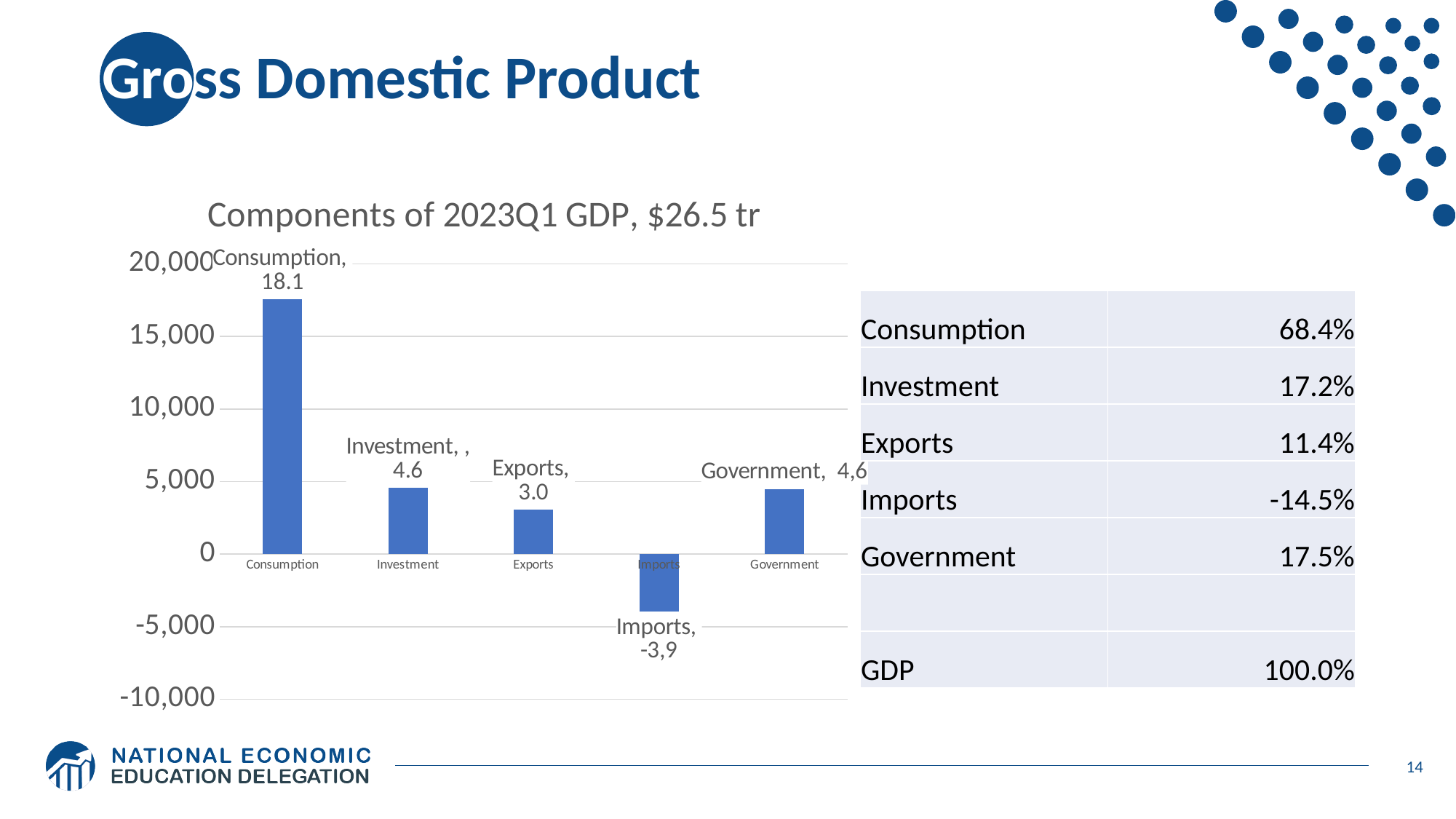
What is the difference between the labelled values for Consumption (18.1) and Exports (3.0)? 15.1 Is the bar for Investment greater or less than 5,000 on the axis? less Which component has the lowest bar in the chart? Imports What is the data label value for Consumption in the Components of 2023Q1 GDP chart? 18.1 How many components (bars) are plotted in the chart? 5 What is the title of the chart? Components of 2023Q1 GDP, $26.5 tr Is the bar for Consumption greater or less than 15,000 on the axis? greater What kind of chart is shown on the slide? bar chart What is the data label value for Exports in the chart? 3.0 Which is larger, the value for Investment or the value for Exports? Investment Which component has the highest bar in the chart? Consumption What is the data label value for Imports in the chart? -3,9